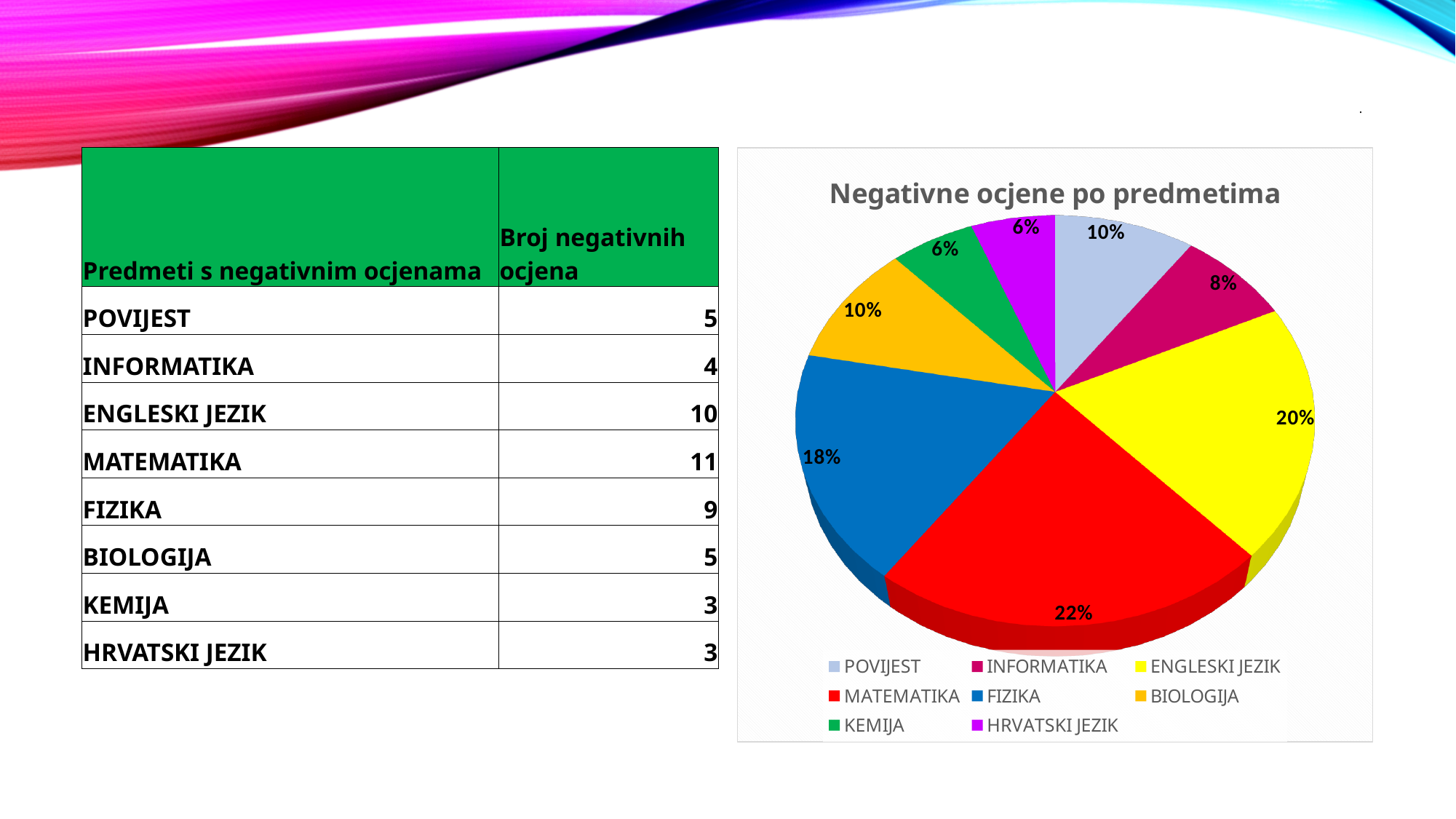
Which colour represents ENGLESKI JEZIK in the pie chart? yellow What percentage of the pie does FIZIKA take? 18% How many slices does the pie chart have? 8 What is the title of the chart? Negativne ocjene po predmetima What percentage of the pie does KEMIJA take? 6% Which subject has the largest slice of the pie? MATEMATIKA Which slice is larger, FIZIKA or POVIJEST? FIZIKA What percentage of the pie does ENGLESKI JEZIK take? 20% What is the difference in percentage points between the MATEMATIKA slice and the INFORMATIKA slice? 14 What kind of chart is shown on the slide? pie chart